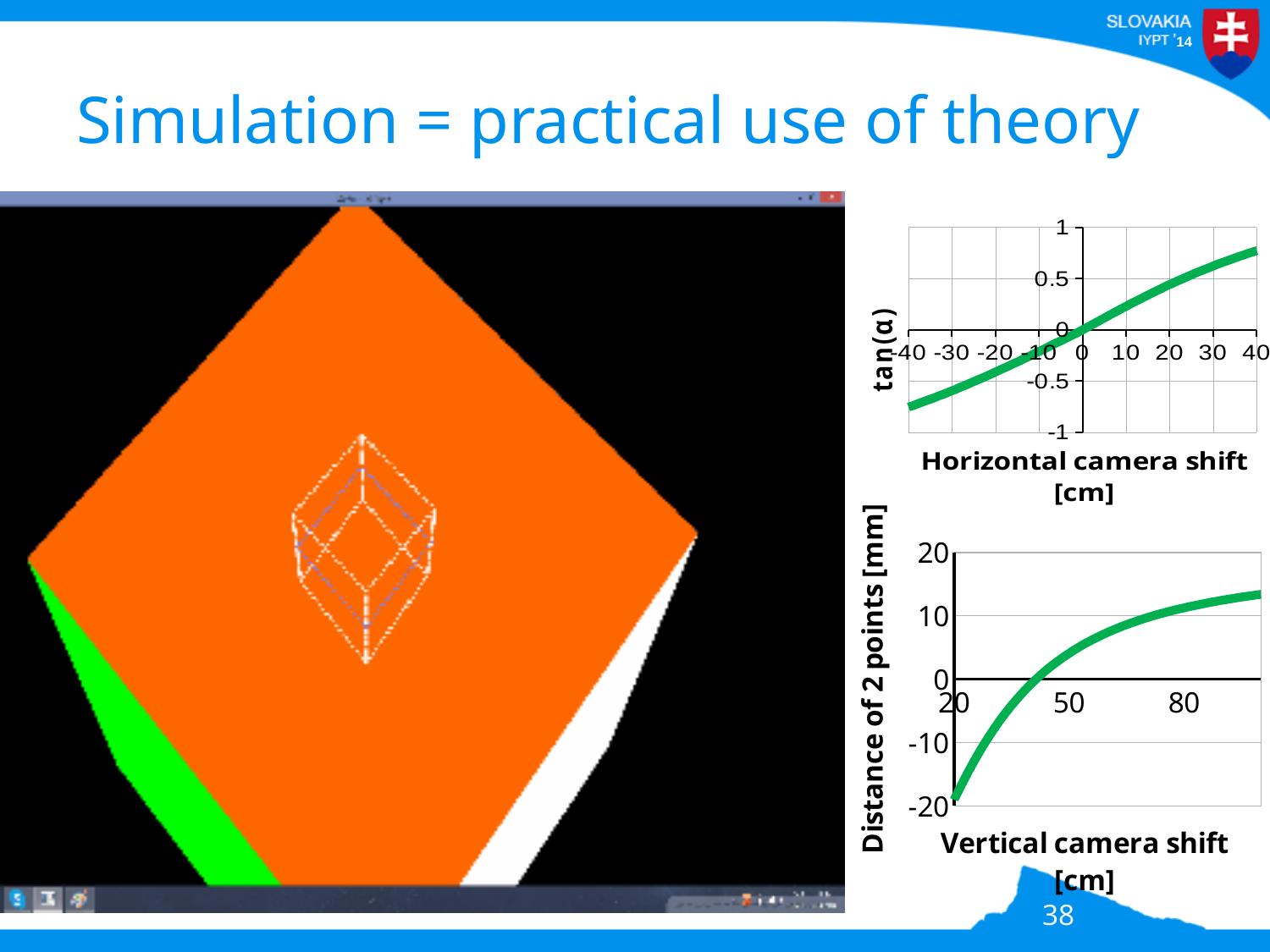
In the bottom-right chart, is the distance of 2 points at a vertical camera shift of 20 cm greater or less than -10? less In the top-right chart, does tan(α) rise or fall as the horizontal camera shift increases from -40 to 40? rise In the bottom-right chart, is the distance of 2 points at a vertical camera shift of 50 cm greater or less than 0? greater In the top-right chart, is the value of tan(α) at a horizontal camera shift of 20 cm greater or less than 0? greater In the top-right chart, what is the label of the y axis? tan(α) What kind of chart is the bottom-right chart with the x axis 'Vertical camera shift [cm]'? line chart In the bottom-right chart, does the distance of 2 points rise or fall as the vertical camera shift increases? rise What kind of chart is the top-right chart with the x axis 'Horizontal camera shift [cm]'? line chart In the bottom-right chart, what is the label of the y axis? Distance of 2 points [mm]